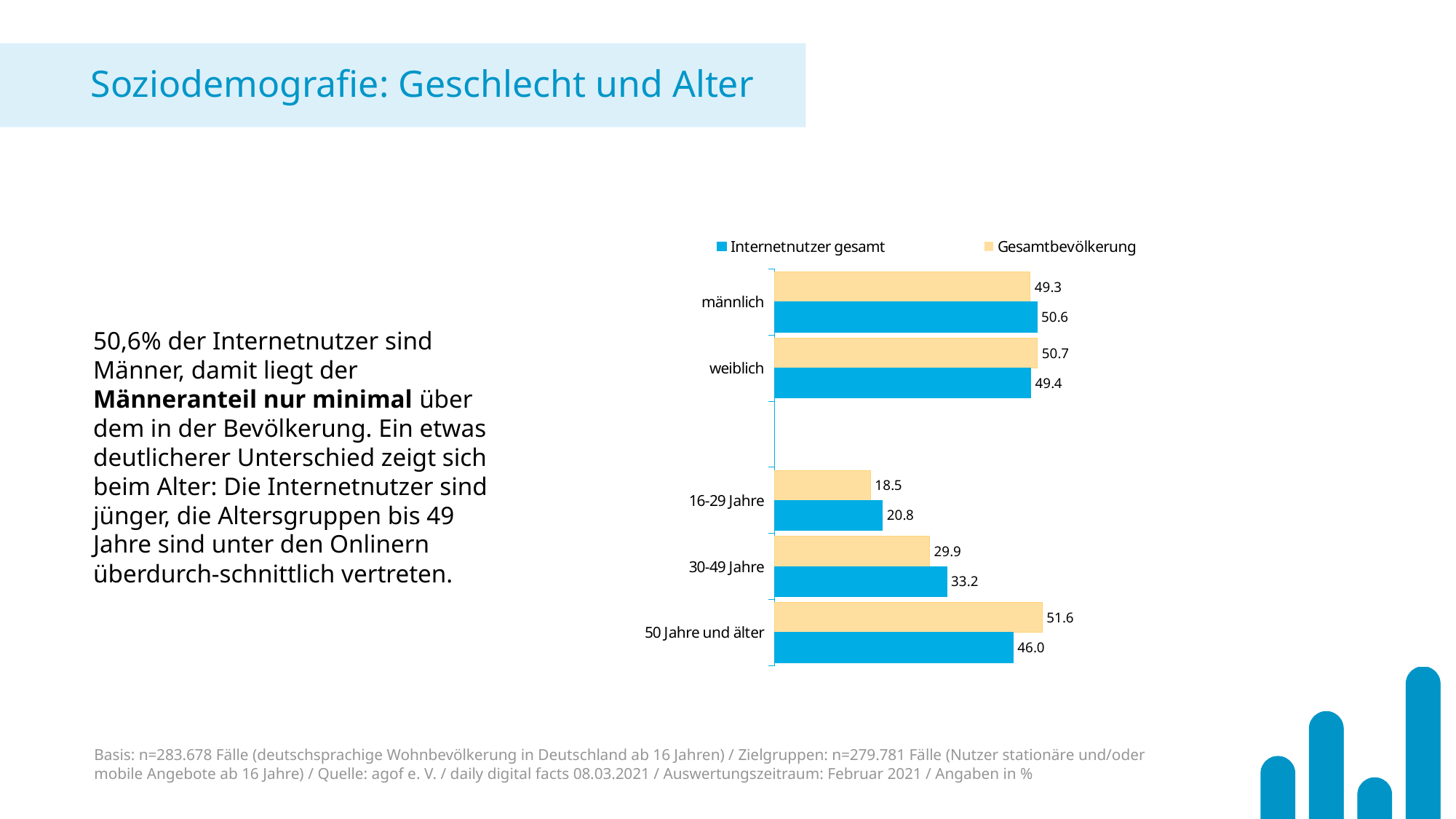
Which colour represents the Gesamtbevölkerung series? yellow Which age group has the lowest value for Gesamtbevölkerung? 16-29 Jahre What kind of chart is shown on the slide? bar chart In the 30-49 Jahre category, which is larger: Internetnutzer gesamt or Gesamtbevölkerung? Internetnutzer gesamt How many categories are shown on the chart? 5 Which age group has the highest value for Internetnutzer gesamt? 50 Jahre und älter What is the value for Internetnutzer gesamt in the männlich category? 50.6 What is the value for Internetnutzer gesamt in the 16-29 Jahre category? 20.8 What is the value for Gesamtbevölkerung in the 50 Jahre und älter category? 51.6 What is the value for Gesamtbevölkerung in the weiblich category? 50.7 What is the difference between Gesamtbevölkerung and Internetnutzer gesamt in the 50 Jahre und älter category? 5.6 How many series does the chart legend list? 2